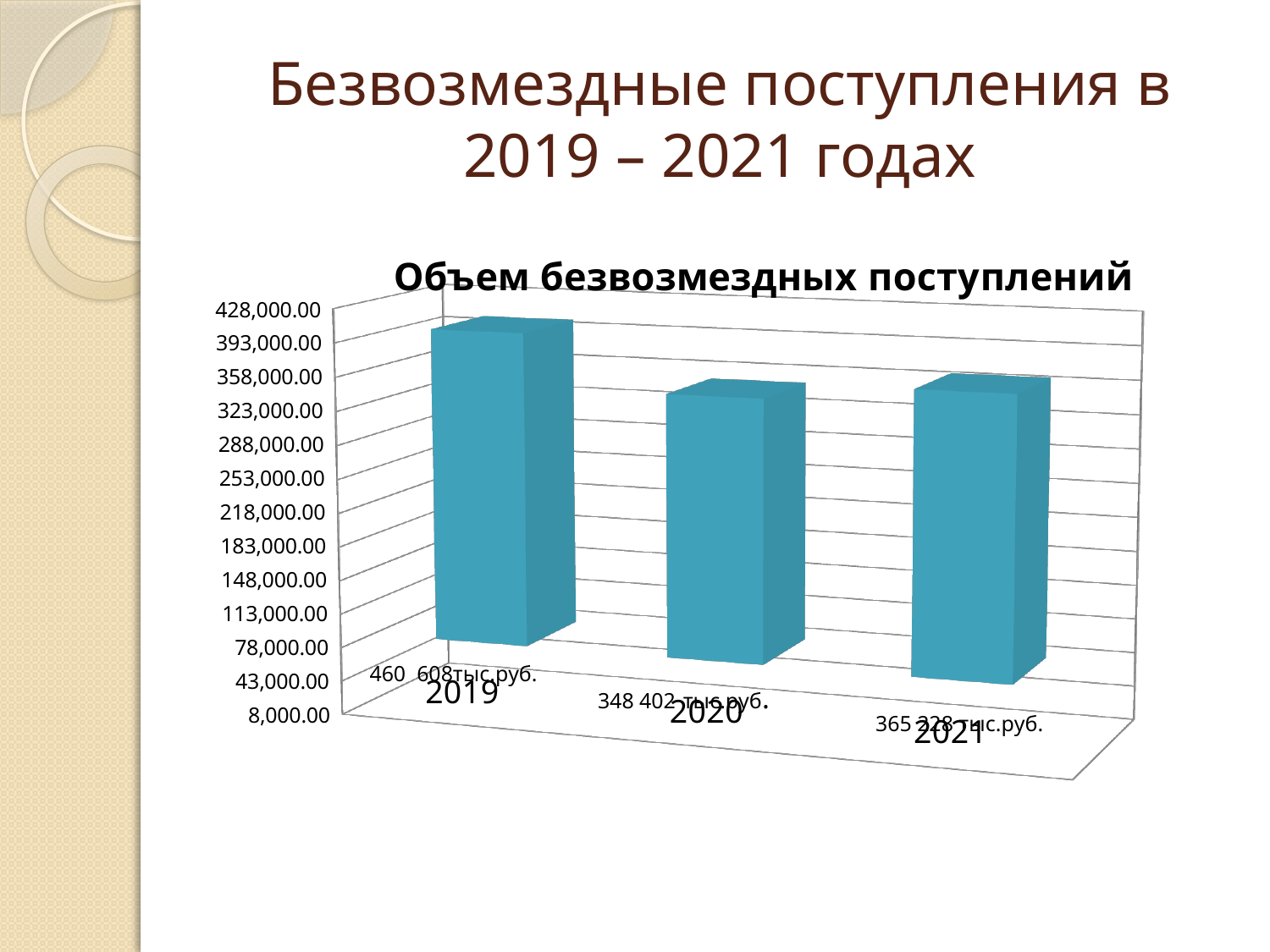
Which year has the highest bar? 2019 What value is printed for 2019? 460 608тыс.руб. Is the bar for 2020 greater or less than 358,000.00 on the axis? less Is the bar for 2021 greater or less than 288,000.00 on the axis? greater What value is printed for 2020? 348 402 тыс.руб. How many years (categories) are plotted in the chart? 3 What is the title of the chart? Объем безвозмездных поступлений Does the value rise or fall from 2019 to 2020? fall What is the difference between the printed values for 2019 and 2020? 112 206 тыс.руб. Is the bar for 2019 greater or less than 358,000.00 on the axis? greater What type of chart is shown on the slide? bar chart Which is larger, the value for 2019 or the value for 2020? 2019